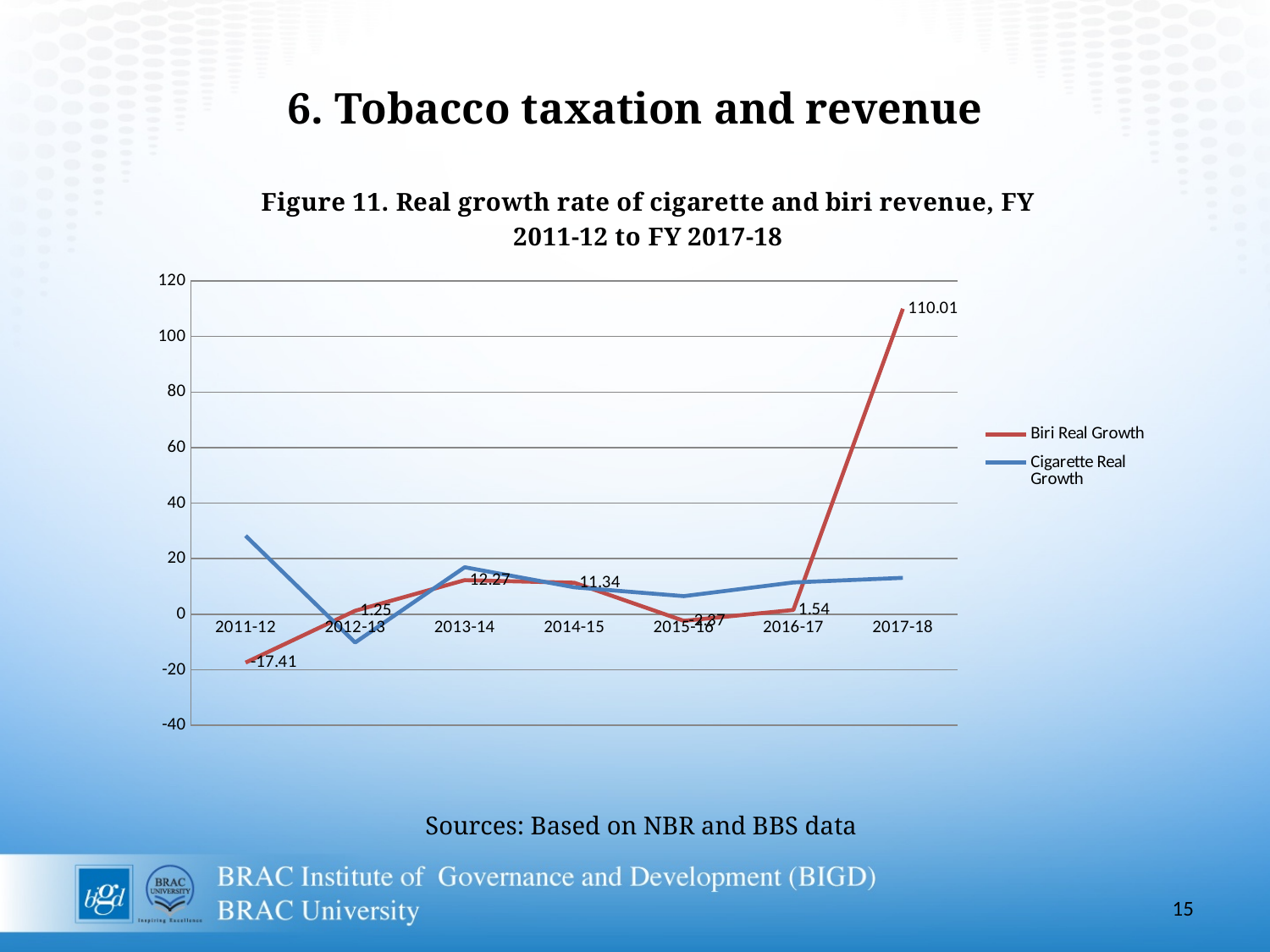
How many fiscal years are shown on the x axis of the chart? 7 What is the difference between the Biri Real Growth values for FY 2013-14 and FY 2014-15? 0.93 Which is larger, the Biri Real Growth value for FY 2012-13 or for FY 2016-17? 2016-17 In which fiscal year is Biri Real Growth lowest? 2011-12 Is the Cigarette Real Growth value for FY 2011-12 greater or less than 20? greater What is the Biri Real Growth value for FY 2017-18? 110.01 What kind of chart is Figure 11? line chart What is the Biri Real Growth value for FY 2011-12? -17.41 How many series does the chart's legend list? 2 In which fiscal year is Biri Real Growth highest? 2017-18 Is the Cigarette Real Growth value for FY 2012-13 greater or less than 0? less What is the Biri Real Growth value for FY 2013-14? 12.27